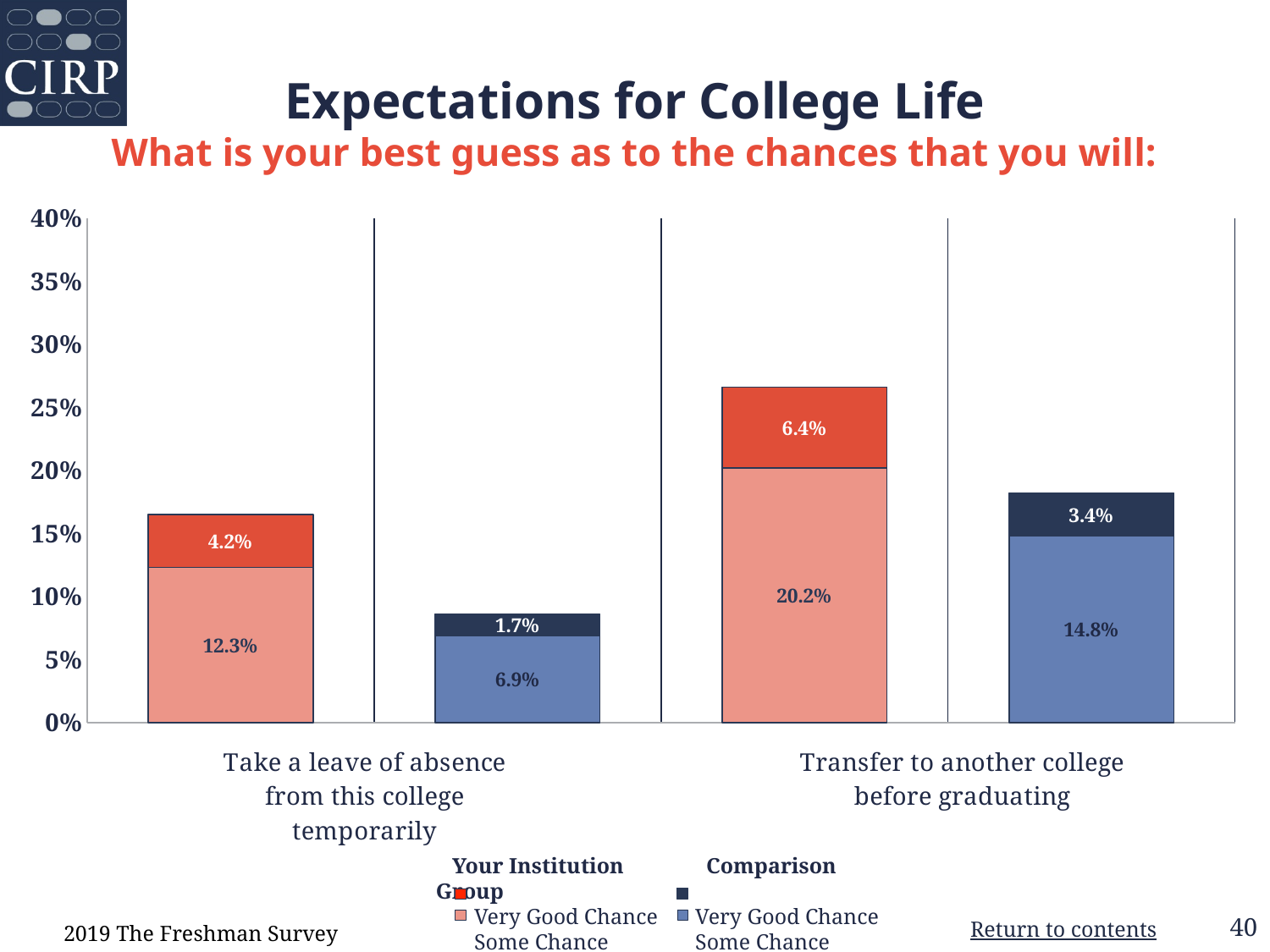
What is the difference between the 'Some Chance' values for Your Institution and the Comparison Group for transferring to another college before graduating? 5.4% What is the 'Some Chance' value for Your Institution for transferring to another college before graduating? 20.2% How many question categories are shown on the x axis of the chart? 2 What is the total height of the Your Institution bar for 'Transfer to another college before graduating'? 26.6% What percentage of students at Your Institution said there is a 'Very Good Chance' they will take a leave of absence from this college temporarily? 4.2% What percentage of the Comparison Group said there is 'Some Chance' they will transfer to another college before graduating? 14.8% What is the total height of the Comparison Group bar for 'Take a leave of absence from this college temporarily'? 8.6% Which is larger: the 'Very Good Chance' value for Your Institution or for the Comparison Group for taking a leave of absence temporarily? Your Institution What type of chart is shown on the slide? Stacked bar chart Which bar is the tallest on the chart? Your Institution, Transfer to another college before graduating Which bar is the shortest on the chart? Comparison Group, Take a leave of absence from this college temporarily What is the 'Very Good Chance' value for the Comparison Group for taking a leave of absence from this college temporarily? 1.7%